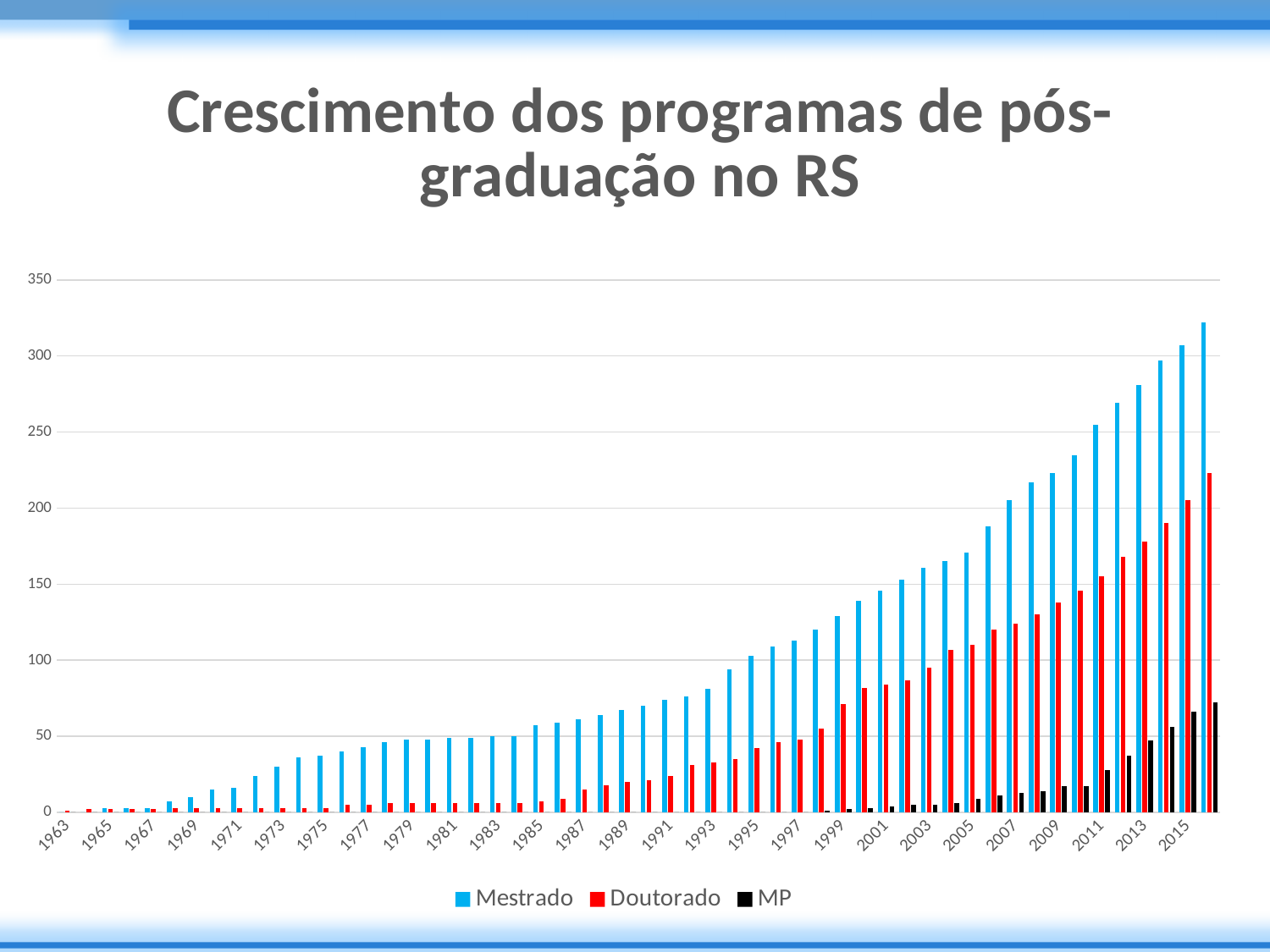
Is the MP value for 2015 greater or less than 50? greater How many series does the legend list? 3 Is the Doutorado value for 2001 greater or less than 100? less Is the Mestrado value for 2013 greater or less than 250? greater Which series has the lowest value in 2015? MP In 2015, which is larger, the Mestrado value or the Doutorado value? Mestrado What kind of chart is shown on the slide? bar chart Do the Mestrado values rise or fall from 1963 to 2015? rise What are the three series named in the legend? Mestrado, Doutorado, MP What is the title of the chart? Crescimento dos programas de pós-graduação no RS